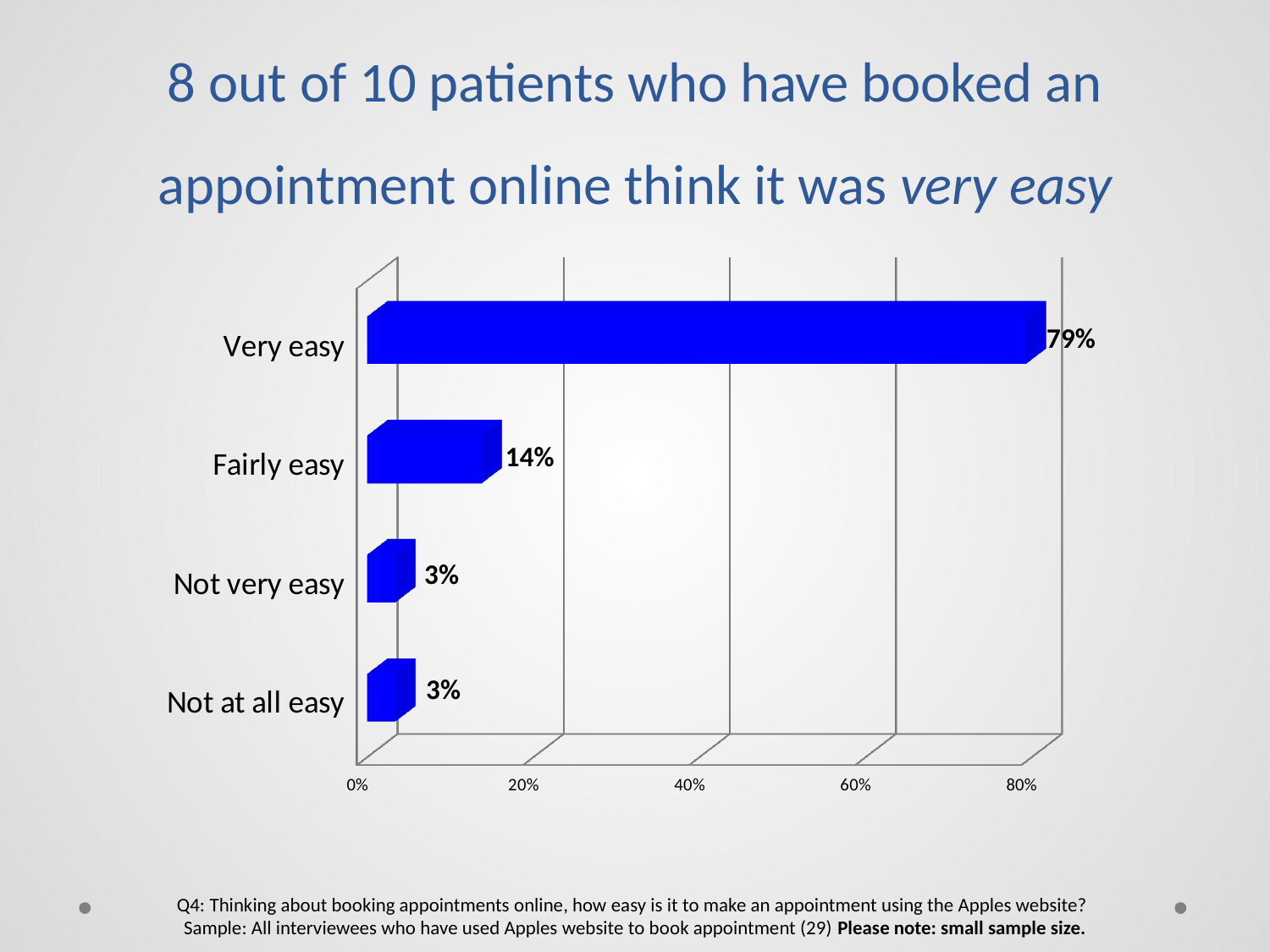
Which is larger, the value for Fairly easy or the value for Not at all easy? Fairly easy Is the value for Fairly easy greater or less than 20%? less What is the combined value of Not very easy and Not at all easy? 6% How many categories are shown in the chart? 4 What is the difference between the Very easy and Fairly easy values? 65% What kind of chart is shown on the slide? Bar chart Is the value for Very easy greater or less than 60%? greater What is the value shown for Fairly easy? 14% What is the value shown for Not very easy? 3% What is the highest value labelled on the horizontal axis? 80% Which category has the highest value? Very easy What percentage of patients said booking an appointment online was very easy? 79%